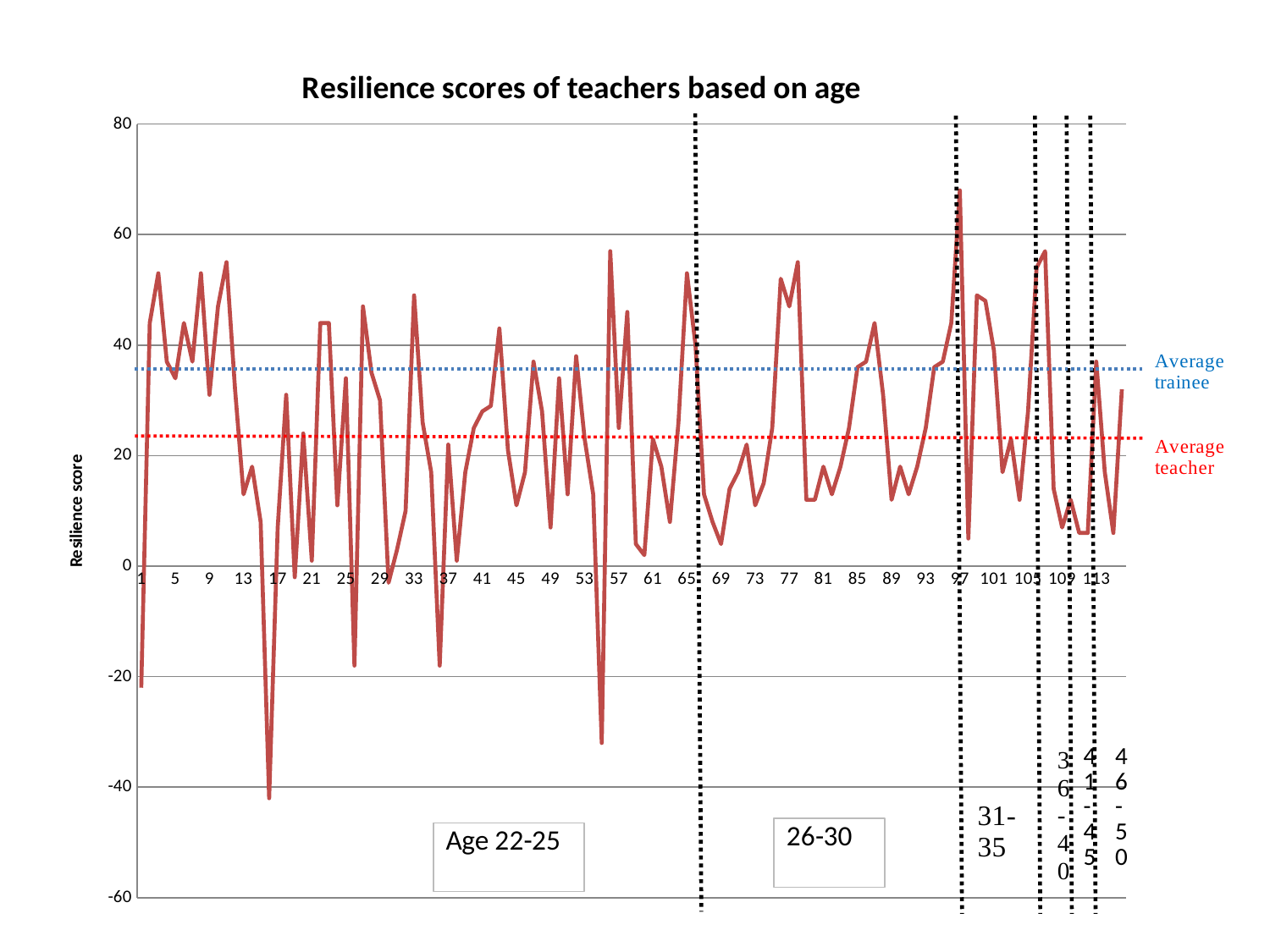
At which x-axis point does the line reach its highest resilience score? 97 Is the 'Average trainee' dotted line greater or less than 40? less At which x-axis point does the line reach its lowest resilience score? 16 Which dotted reference line is higher, 'Average trainee' or 'Average teacher'? Average trainee Is the 'Average teacher' dotted line greater or less than 40? less What is the label on the vertical axis of the chart? Resilience score What is the title of the chart? Resilience scores of teachers based on age Is the resilience score at point 97 greater or less than 60? greater What type of chart is shown on the slide? line chart